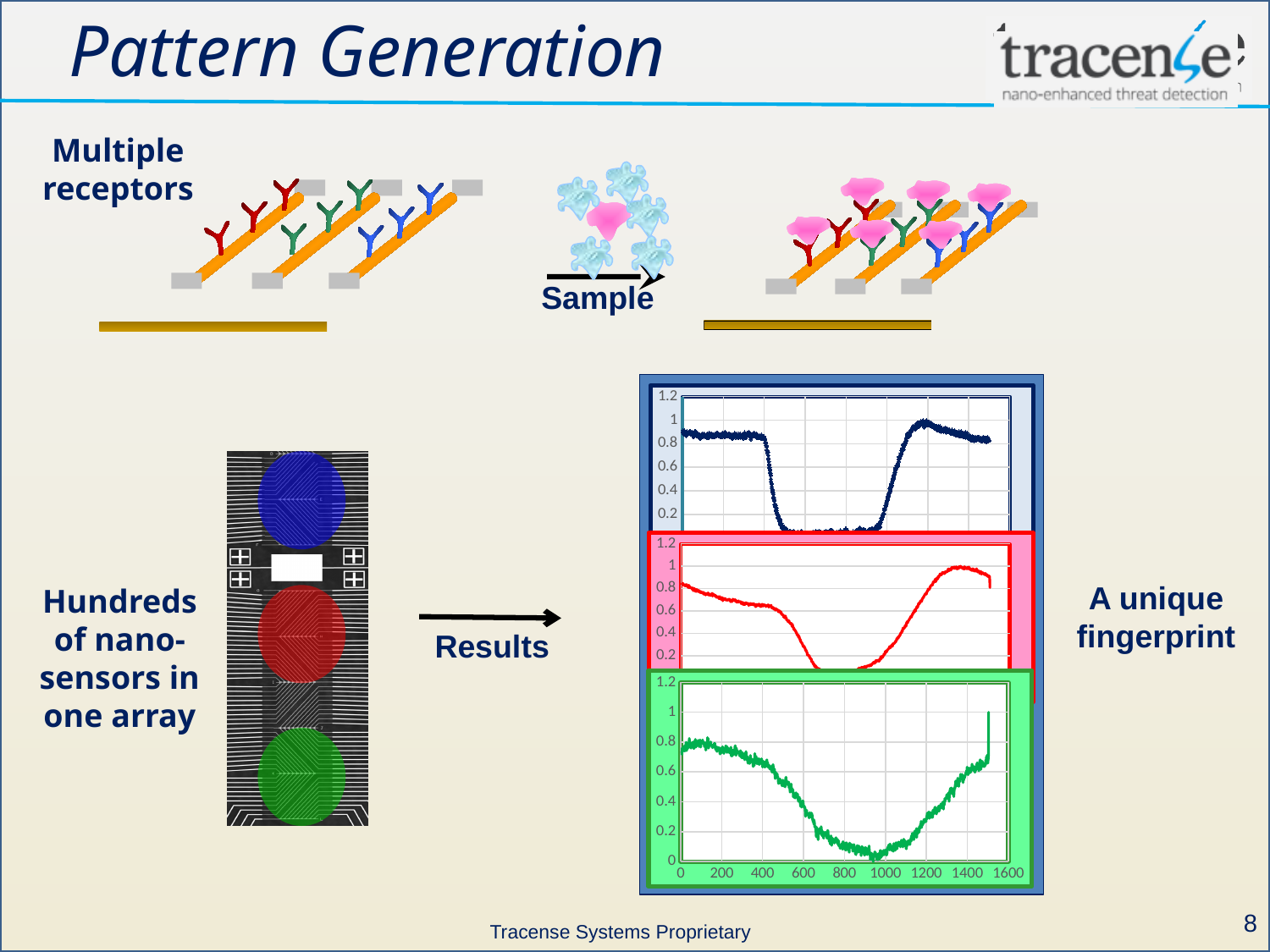
In the middle (red) chart, is the value at x = 1400 greater or less than 0.6? greater In the middle (red) chart, does the line rise or fall between x = 1000 and x = 1400? rise How many charts are stacked in the results panel on the right of the slide? 3 In the top (dark blue) chart, is the value at x = 800 greater or less than 0.4? less In the top (dark blue) chart, is the value at x = 0 greater or less than 0.6? greater In the top (dark blue) chart, what is the highest value labelled on the y axis? 1.2 What kind of chart is the top chart in the results panel? line chart In the bottom (green) chart, what is the highest value labelled on the x axis? 1600 In the bottom (green) chart, does the line rise or fall between x = 0 and x = 1000? fall